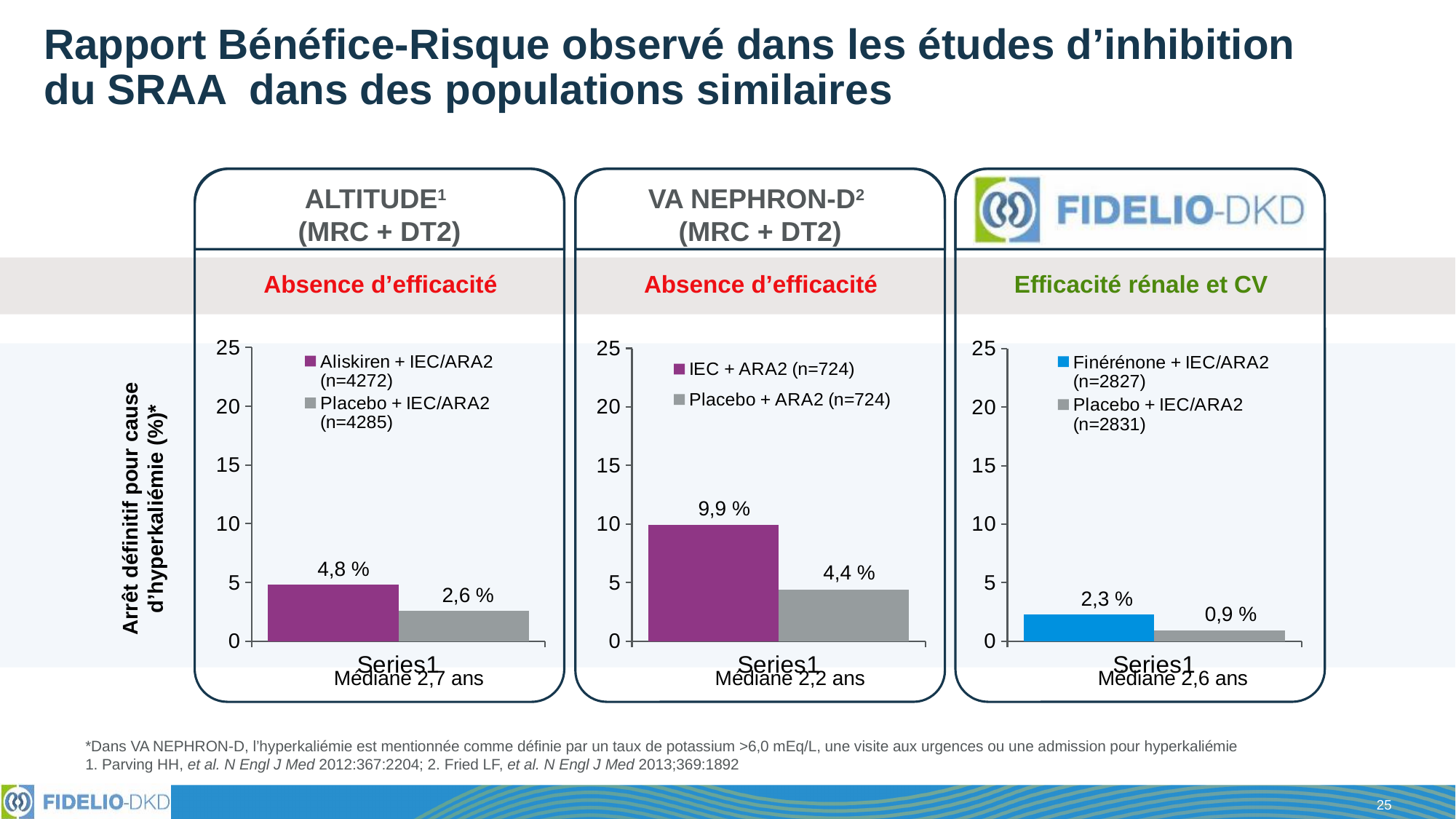
In the VA NEPHRON-D chart, what is the difference between the IEC + ARA2 value and the Placebo + ARA2 value? 5,5 % In the FIDELIO-DKD chart, which series has the higher value, Finérénone + IEC/ARA2 or Placebo + IEC/ARA2? Finérénone + IEC/ARA2 In the ALTITUDE chart, what is the value for Placebo + IEC/ARA2 (n=4285)? 2,6 % How many series does the legend of the VA NEPHRON-D chart list? 2 In the FIDELIO-DKD chart, what is the value for Finérénone + IEC/ARA2 (n=2827)? 2,3 % In the FIDELIO-DKD chart, what is the value for Placebo + IEC/ARA2 (n=2831)? 0,9 % In the VA NEPHRON-D chart, what is the value for IEC + ARA2 (n=724)? 9,9 % In the VA NEPHRON-D chart, what is the value for Placebo + ARA2 (n=724)? 4,4 % What is the y-axis label shared by the three charts? Arrêt définitif pour cause d'hyperkaliémie (%)* What kind of chart is the FIDELIO-DKD chart? Bar chart In the ALTITUDE chart, what is the value for Aliskiren + IEC/ARA2 (n=4272)? 4,8 % In the ALTITUDE chart, what is the difference between the Aliskiren + IEC/ARA2 value and the Placebo + IEC/ARA2 value? 2,2 %